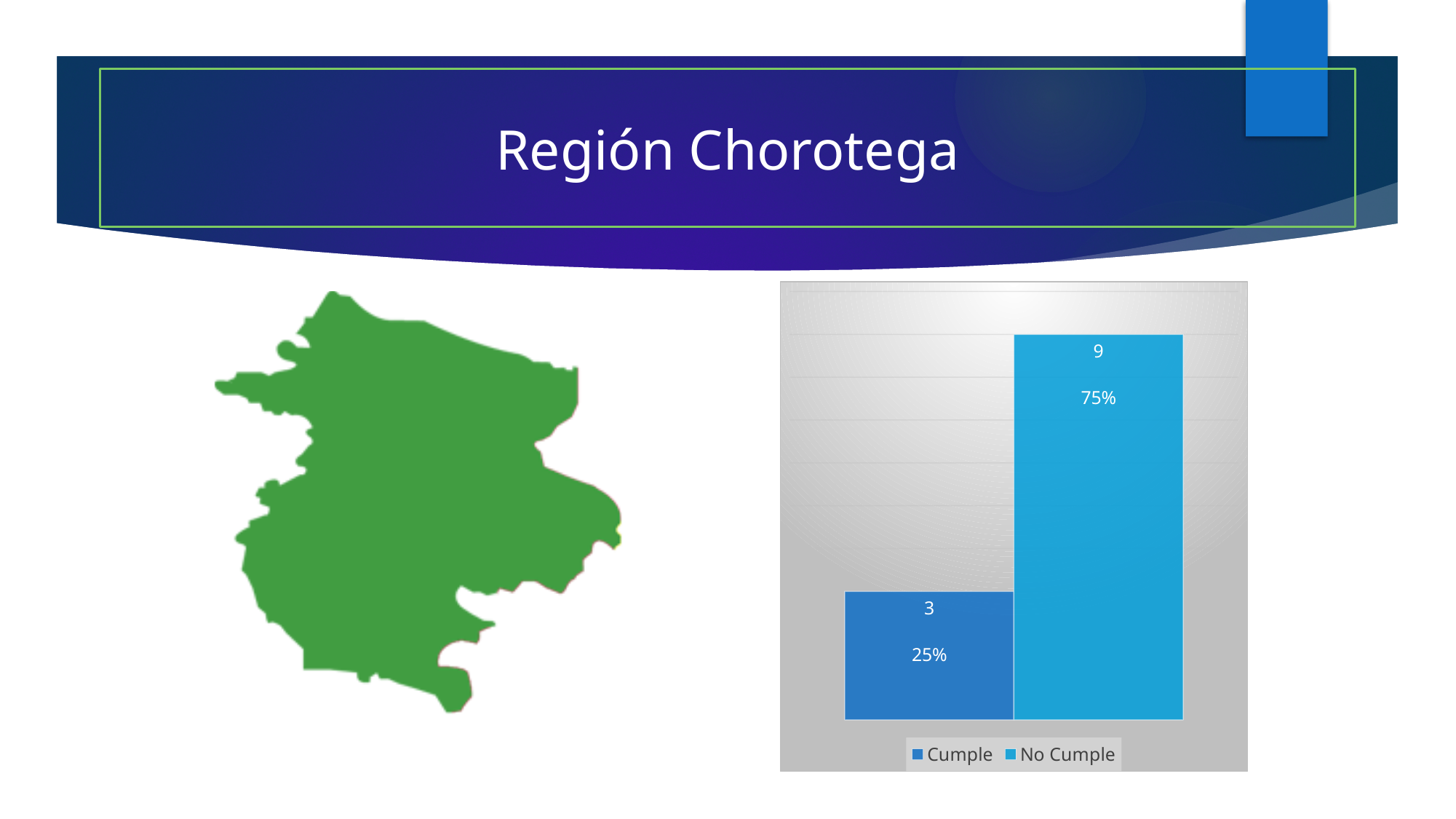
What percentage is shown for No Cumple? 75% Which series has the highest value? No Cumple What is the difference between the values for No Cumple and Cumple? 6 Which is larger, Cumple or No Cumple? No Cumple What is the value for Cumple? 3 What is the value for No Cumple? 9 Which series has the lowest value? Cumple What kind of chart is shown on the slide? Bar chart How many series does the legend list? 2 What is the title of the slide containing the chart? Región Chorotega What is the total of the values for Cumple and No Cumple? 12 What percentage is shown for Cumple? 25%